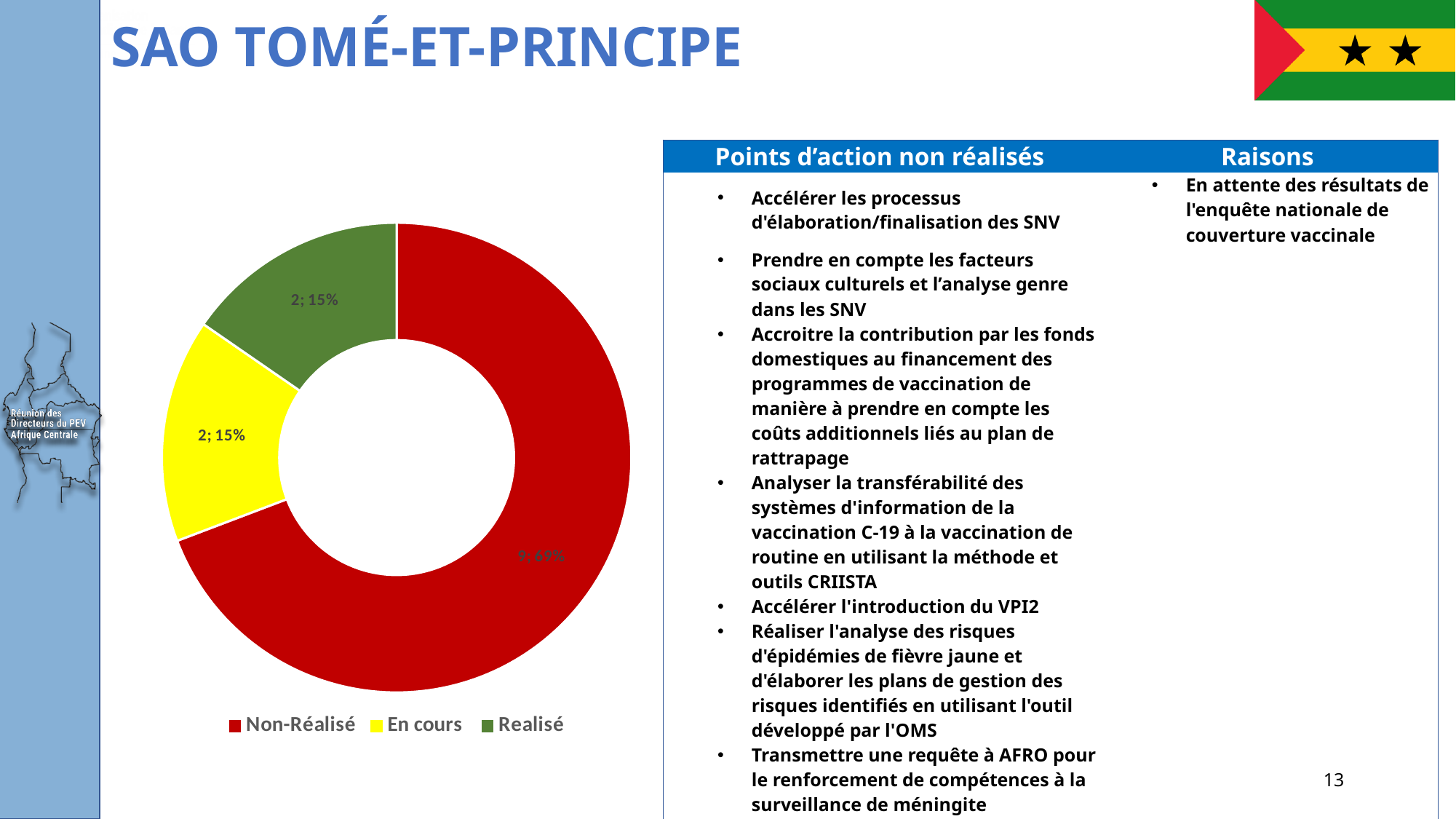
What percentage share does the Non-Réalisé slice represent? 69% What colour is used for the Realisé slice in the chart? green Which category has the largest slice in the chart? Non-Réalisé Which is larger, the Non-Réalisé slice or the En cours slice? Non-Réalisé What is the count shown for the En cours slice? 2 What kind of chart is shown on the slide? doughnut chart How many categories does the legend of the chart list? 3 What is the total count across all three slices of the chart? 13 What is the difference between the count for Non-Réalisé and the count for Realisé? 7 How many slices does the doughnut chart have? 3 What is the count shown for the Non-Réalisé slice? 9 What percentage share does the Realisé slice represent? 15%